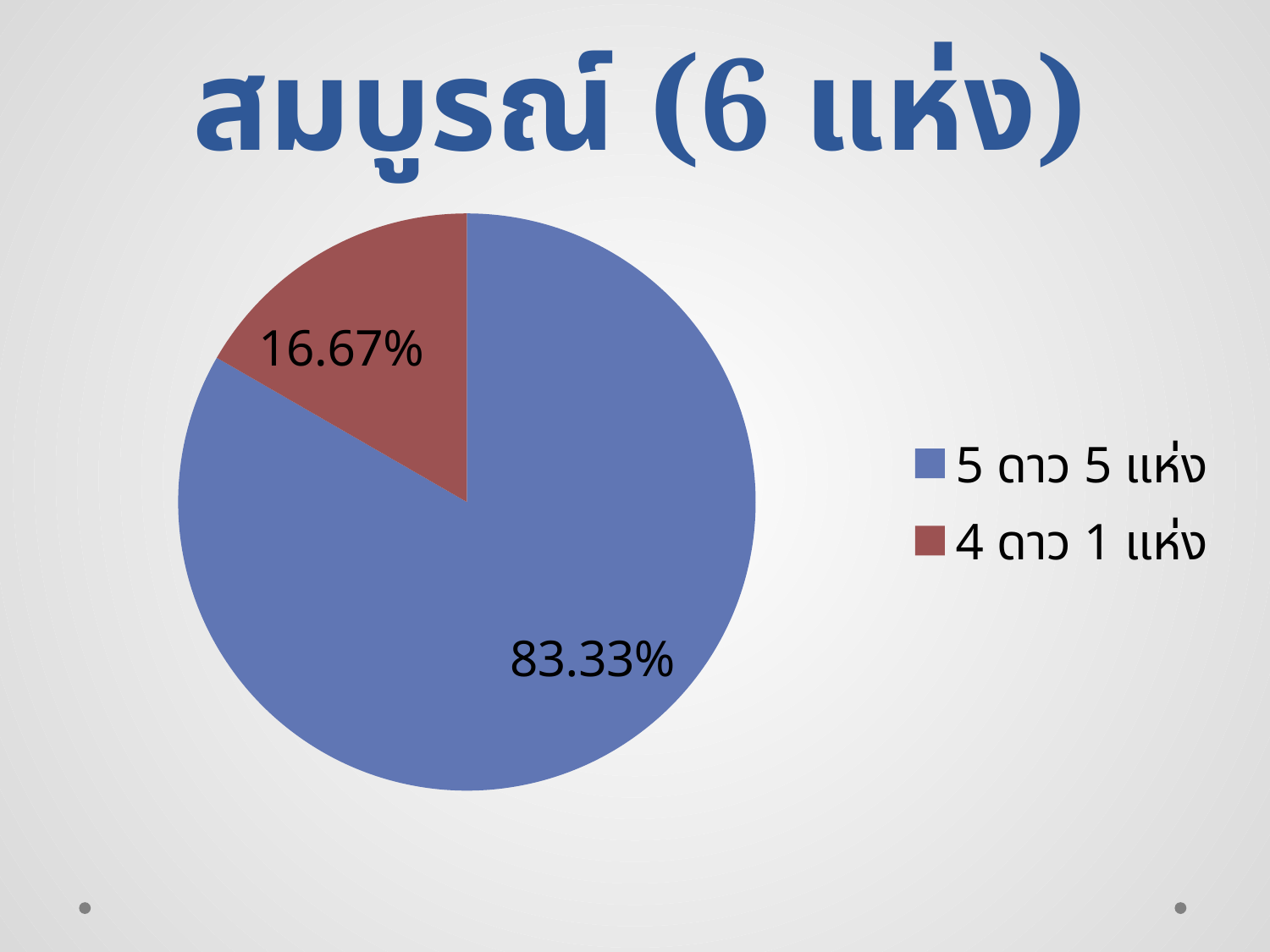
What colour is the "4 ดาว 1 แห่ง" slice? red How many slices does the pie chart have? 2 Which slice is the largest in the pie chart? 5 ดาว 5 แห่ง Which is larger: the "5 ดาว 5 แห่ง" slice or the "4 ดาว 1 แห่ง" slice? 5 ดาว 5 แห่ง How many entries does the legend list? 2 What share of the pie does the "5 ดาว 5 แห่ง" slice represent? 83.33% What kind of chart is shown on the slide? pie chart Which slice is the smallest in the pie chart? 4 ดาว 1 แห่ง What share of the pie does the "4 ดาว 1 แห่ง" slice represent? 16.67% What is the difference in percentage points between the "5 ดาว 5 แห่ง" slice and the "4 ดาว 1 แห่ง" slice? 66.66% What is the title of the slide? สมบูรณ์ (6 แห่ง)